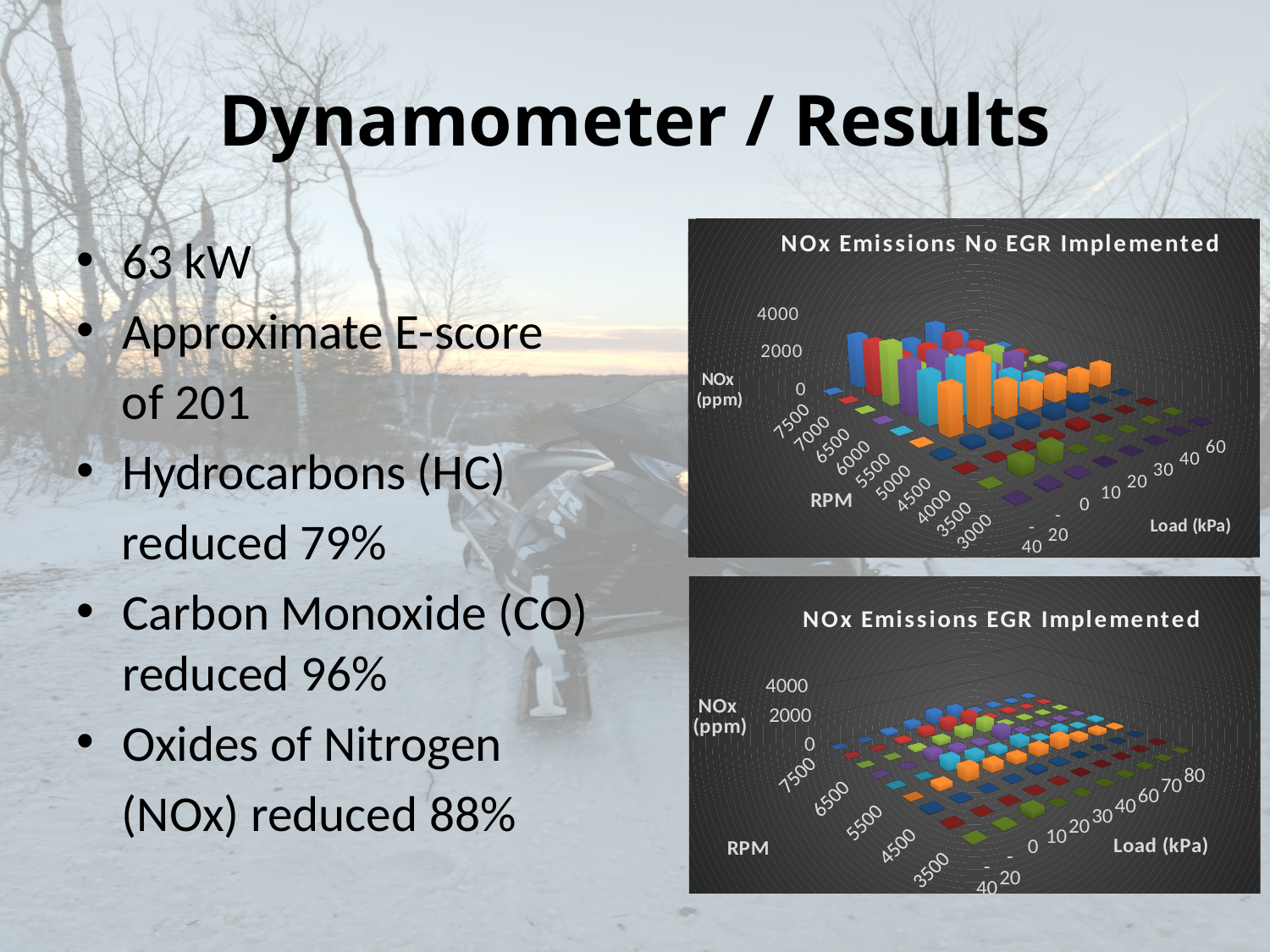
In the bottom chart, 'NOx Emissions EGR Implemented', what is the highest Load (kPa) tick shown? 80 In the top chart, 'NOx Emissions No EGR Implemented', what is the lowest RPM tick shown on the RPM axis? 3000 In the top chart, 'NOx Emissions No EGR Implemented', what is the label of the vertical axis? NOx (ppm) In the bottom chart, 'NOx Emissions EGR Implemented', are the bar values greater or less than 2000 ppm? less In the bottom chart, 'NOx Emissions EGR Implemented', what is the highest tick value shown on the NOx (ppm) axis? 4000 What is the title of the bottom chart on the slide? NOx Emissions EGR Implemented In the top chart, 'NOx Emissions No EGR Implemented', what is the highest RPM tick shown on the RPM axis? 7500 How many charts are shown on the slide? 2 What type of chart is the bottom chart, 'NOx Emissions EGR Implemented'? 3D bar chart What type of chart is the top chart, 'NOx Emissions No EGR Implemented'? 3D bar chart In the top chart, 'NOx Emissions No EGR Implemented', what is the highest Load (kPa) tick shown? 60 What is the title of the top chart on the slide? NOx Emissions No EGR Implemented